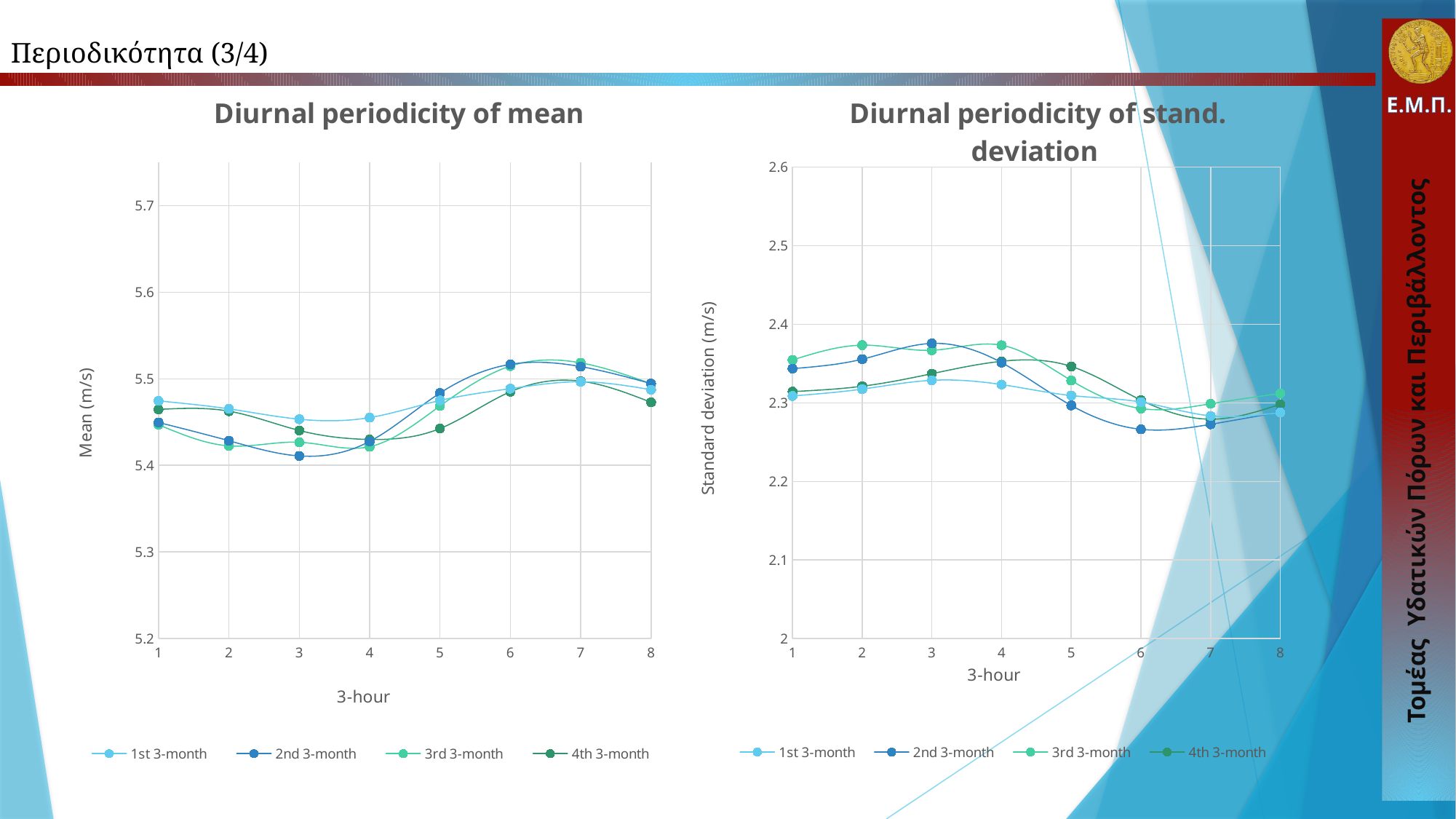
How many points along the x axis does each series in the "Diurnal periodicity of stand. deviation" chart have? 8 In the "Diurnal periodicity of mean" chart, is the value for 1st 3-month at 3-hour 1 greater or less than 5.5? less In the "Diurnal periodicity of mean" chart, is the value for 4th 3-month at 3-hour 5 greater or less than 5.5? less What is the y-axis label of the "Diurnal periodicity of stand. deviation" chart? Standard deviation (m/s) In the "Diurnal periodicity of stand. deviation" chart, is the value for 2nd 3-month at 3-hour 6 greater or less than 2.3? less What is the x-axis label of the "Diurnal periodicity of mean" chart? 3-hour What kind of chart is the "Diurnal periodicity of mean" chart? line chart How many series does the legend of the "Diurnal periodicity of mean" chart list? 4 In the "Diurnal periodicity of mean" chart, at which 3-hour point does the 2nd 3-month series reach its lowest value? 3 In the "Diurnal periodicity of stand. deviation" chart, does the 2nd 3-month series rise or fall from 3-hour 3 to 3-hour 6? fall